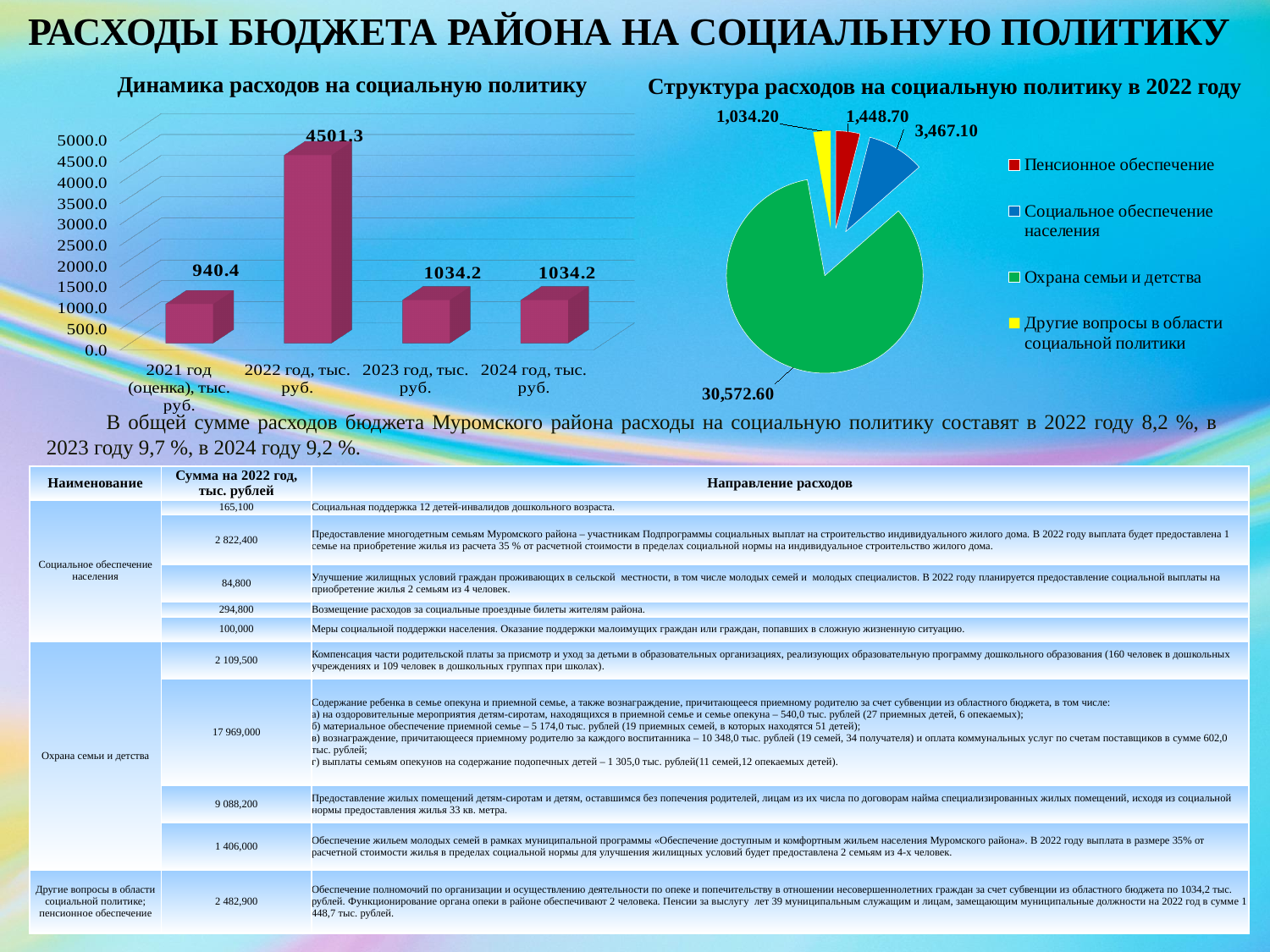
In the bar chart 'Динамика расходов на социальную политику', what is the value for 2021 год (оценка)? 940.4 What type of chart is 'Динамика расходов на социальную политику'? Bar chart In the bar chart 'Динамика расходов на социальную политику', which year has the lowest value? 2021 год (оценка) In the pie chart 'Структура расходов на социальную политику в 2022 году', what is the value for Пенсионное обеспечение? 1,448.70 In the bar chart 'Динамика расходов на социальную политику', which year has the highest value? 2022 год In the bar chart 'Динамика расходов на социальную политику', what is the value for 2022 год? 4501.3 In the pie chart 'Структура расходов на социальную политику в 2022 году', what is the value for Охрана семьи и детства? 30,572.60 In the pie chart 'Структура расходов на социальную политику в 2022 году', which category has the smallest slice? Другие вопросы в области социальной политики In the pie chart 'Структура расходов на социальную политику в 2022 году', what colour is the slice for Охрана семьи и детства? Green In the bar chart 'Динамика расходов на социальную политику', what is the difference between the 2022 and 2021 values? 3560.9 In the pie chart 'Структура расходов на социальную политику в 2022 году', which is larger: Социальное обеспечение населения or Пенсионное обеспечение? Социальное обеспечение населения In the bar chart 'Динамика расходов на социальную политику', how many years are shown? 4